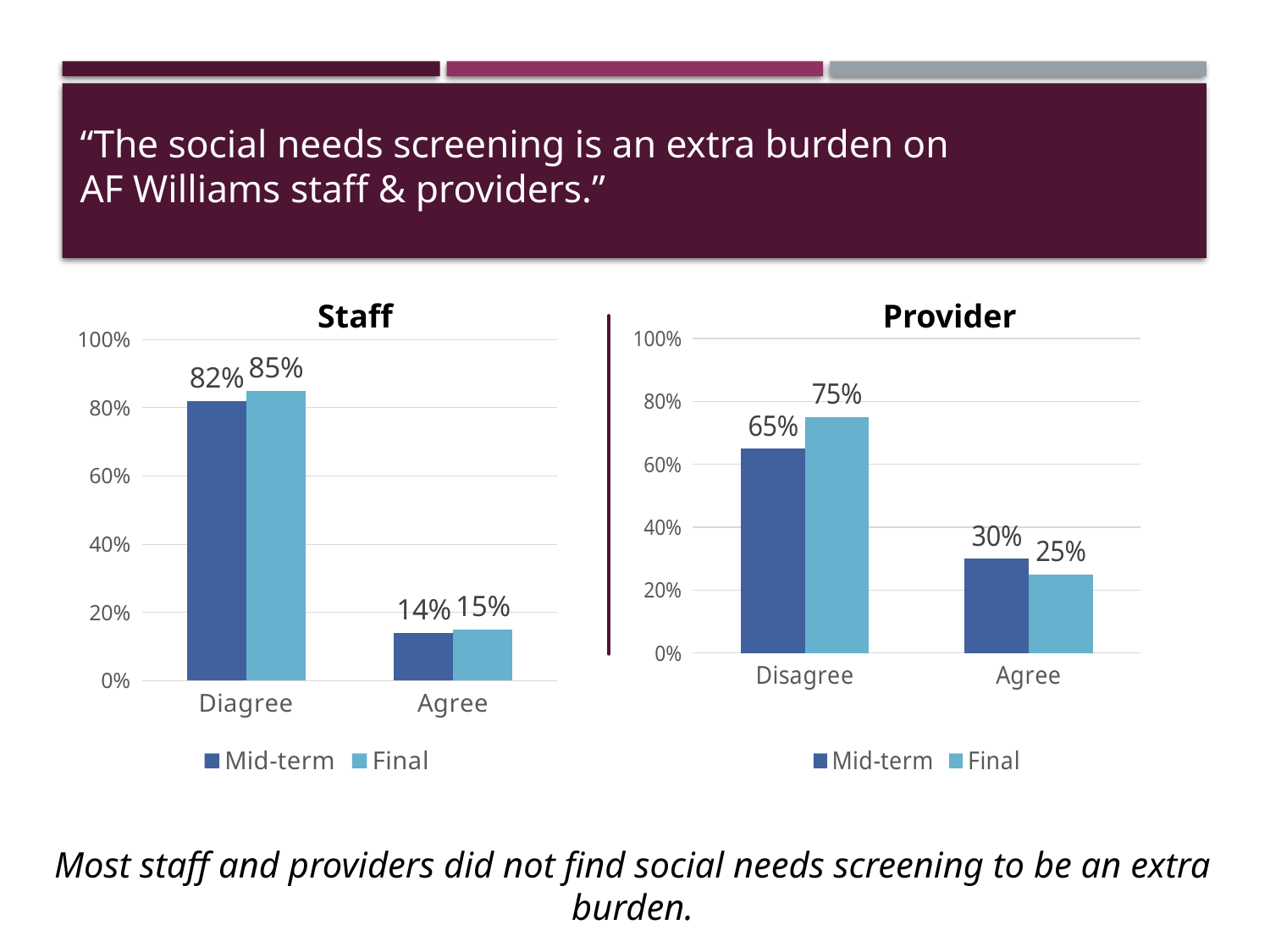
In the Provider chart, what is the Final value for Agree? 25% In the Staff chart, what is the Mid-term value for Agree? 14% In the Staff chart, what is the difference between the Mid-term values for Diagree and Agree? 68% What kind of chart is the Staff chart? Bar chart In the Provider chart, what is the difference between the Final and Mid-term values for Disagree? 10% In the Provider chart, which category has the lowest Final value? Agree In the Provider chart, what is the Mid-term value for Disagree? 65% How many series does the legend of the Provider chart list? 2 In the Staff chart, which category has the highest Final value? Diagree In the Provider chart, which is larger for Agree: the Mid-term value or the Final value? Mid-term In the Staff chart, what is the Final value for Diagree? 85% How many categories are shown on the x axis of the Staff chart? 2